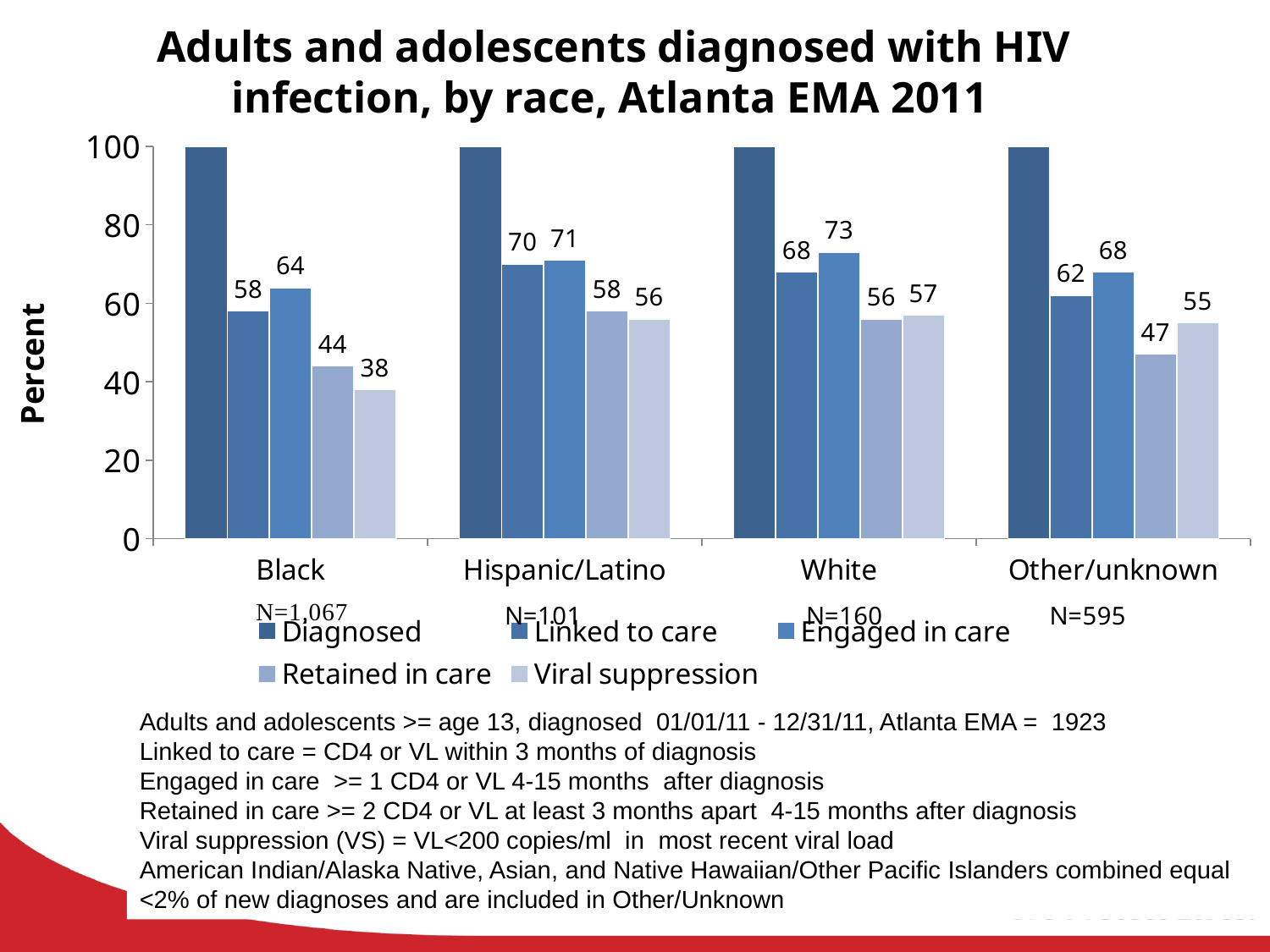
How many race categories are shown on the x axis? 4 How many series does the legend list? 5 Is the Diagnosed value for White greater or less than 80? greater Which race category has the highest Engaged in care value? White What is the Viral suppression value for Black? 38 What kind of chart is shown on the slide? Bar chart What is the difference between the Linked to care and Viral suppression values for Black? 20 Is the Retained in care value for Hispanic/Latino larger or smaller than the Retained in care value for Other/unknown? larger What is the Linked to care value for Hispanic/Latino? 70 Which race category has the lowest Viral suppression value? Black What is the Retained in care value for Other/unknown? 47 What is the Engaged in care value for White? 73